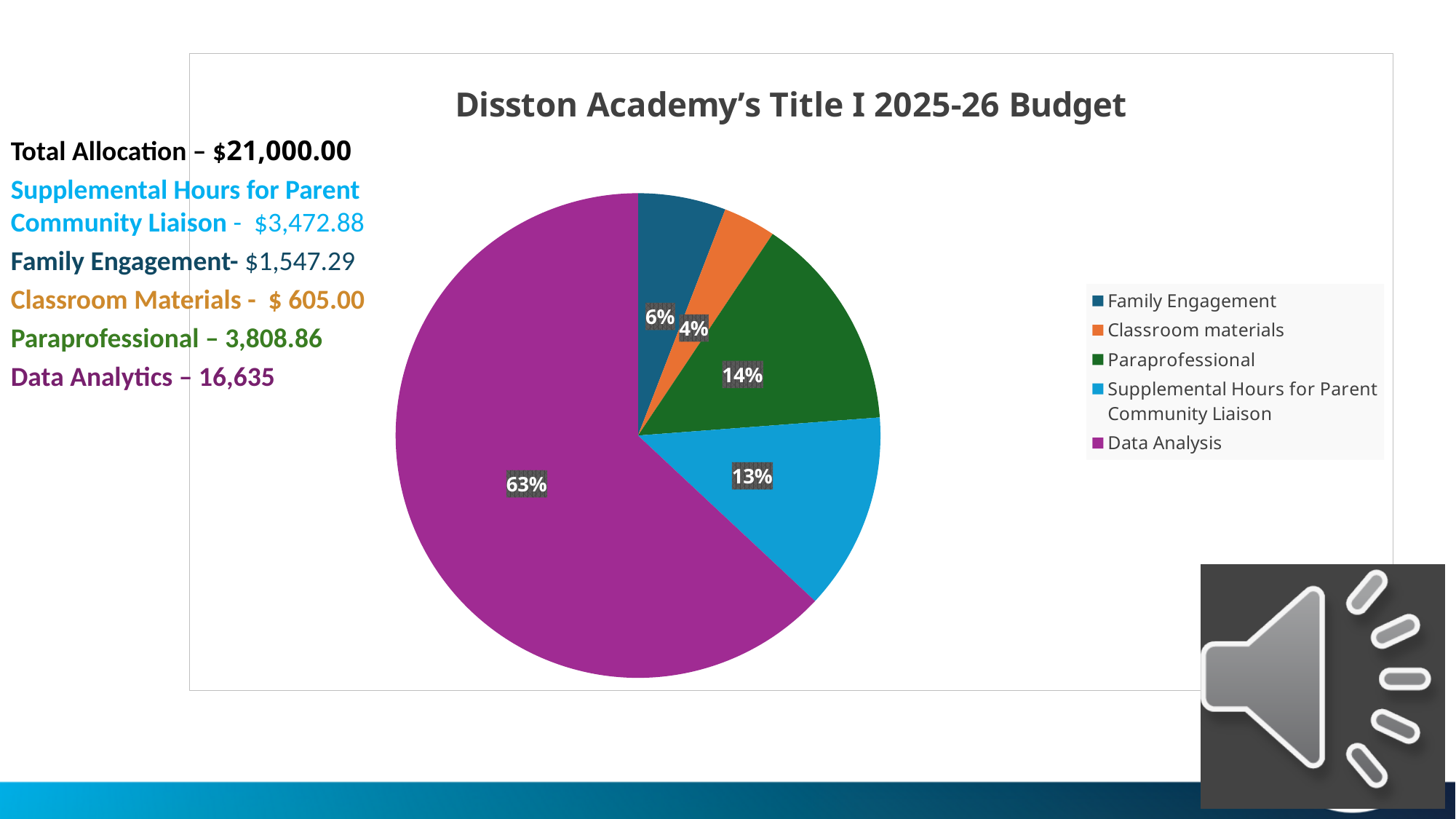
What percentage share does the Supplemental Hours for Parent Community Liaison slice have? 13% What percentage share does the Classroom materials slice have? 4% What percentage share does the Data Analysis slice have? 63% Which has a larger share, Paraprofessional or Family Engagement? Paraprofessional Which category has the largest share of the pie? Data Analysis How many slices does the pie chart have? 5 What is the difference in percentage points between the Data Analysis share and the Paraprofessional share? 49 Which category has the smallest share of the pie? Classroom materials What is the title of the chart? Disston Academy's Title I 2025-26 Budget What type of chart is shown on the slide? pie chart